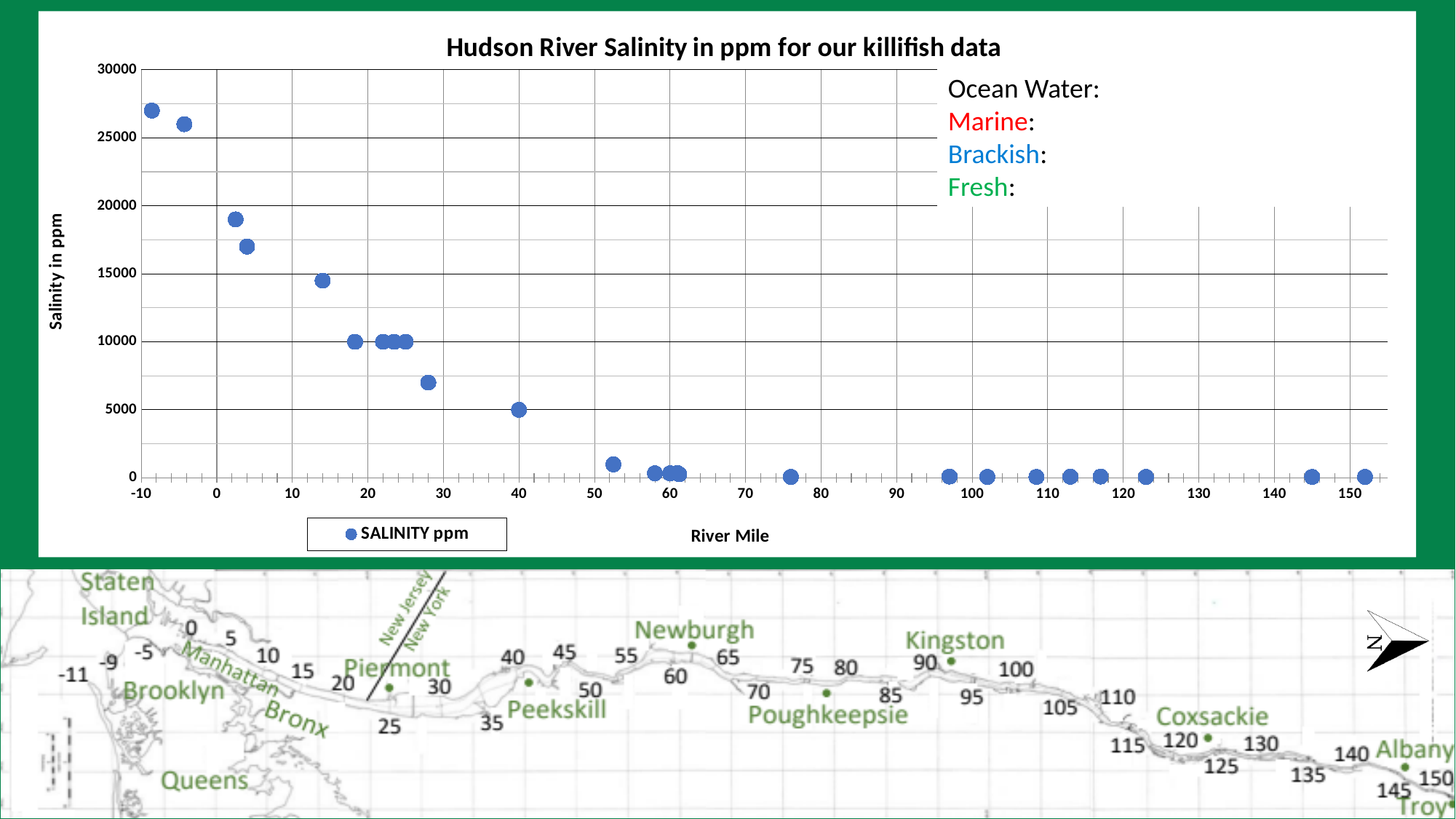
Do the salinity values rise or fall as river mile increases along the x axis? fall Which has the larger salinity value: the point at about river mile 4 or the point at river mile 40? river mile 4 Is the salinity value at about river mile 52 greater or less than 5000? less Is the salinity value for the leftmost point (near river mile -10) greater or less than 25000? greater Is the salinity value at about river mile 28 greater or less than 5000? greater What is the title of the chart? Hudson River Salinity in ppm for our killifish data How many series does the chart legend list? 1 What kind of chart is shown on the slide? scatter chart What is the salinity value plotted at river mile 40? 5000 What is the name of the series shown in the legend? SALINITY ppm